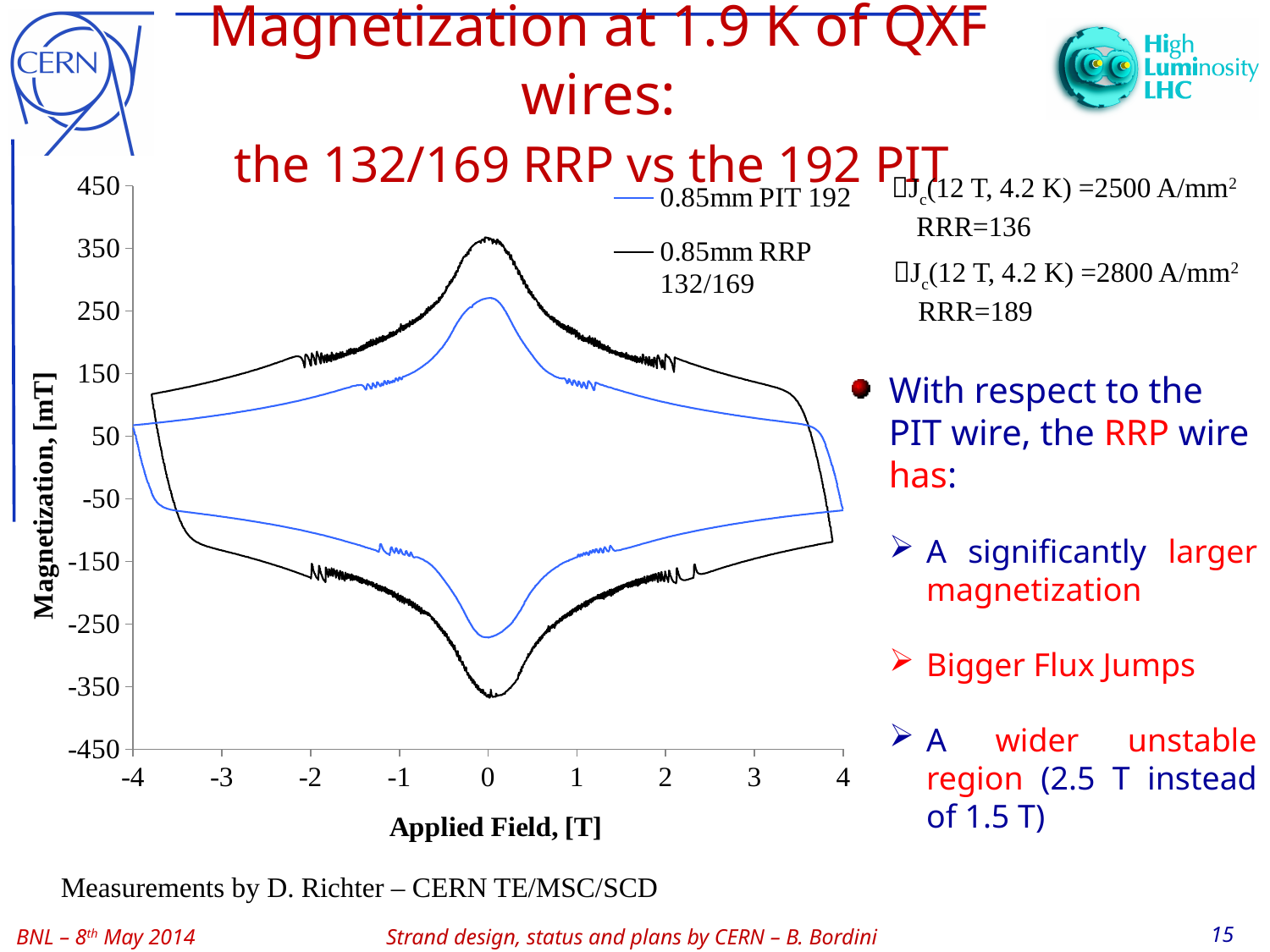
Is the magnetization of the 0.85mm RRP 132/169 series on the upper branch at 2 T applied field greater or less than 150 mT? greater Which series is drawn in blue in the chart? 0.85mm PIT 192 What is the highest value shown on the chart's y axis? 450 Is the peak magnetization of the 0.85mm PIT 192 series near 0 T greater or less than 350 mT? less Does the magnetization of the 0.85mm RRP 132/169 series on the upper branch rise or fall as the applied field increases from 0 T to 3 T? fall Is the magnetization of the 0.85mm PIT 192 series on the upper branch at 2 T applied field greater or less than 150 mT? less What is the label of the chart's x axis? Applied Field, [T] How many series does the chart legend list? 2 What kind of chart is shown on the slide? Line chart Which series reaches the larger peak magnetization near 0 T applied field, 0.85mm PIT 192 or 0.85mm RRP 132/169? 0.85mm RRP 132/169